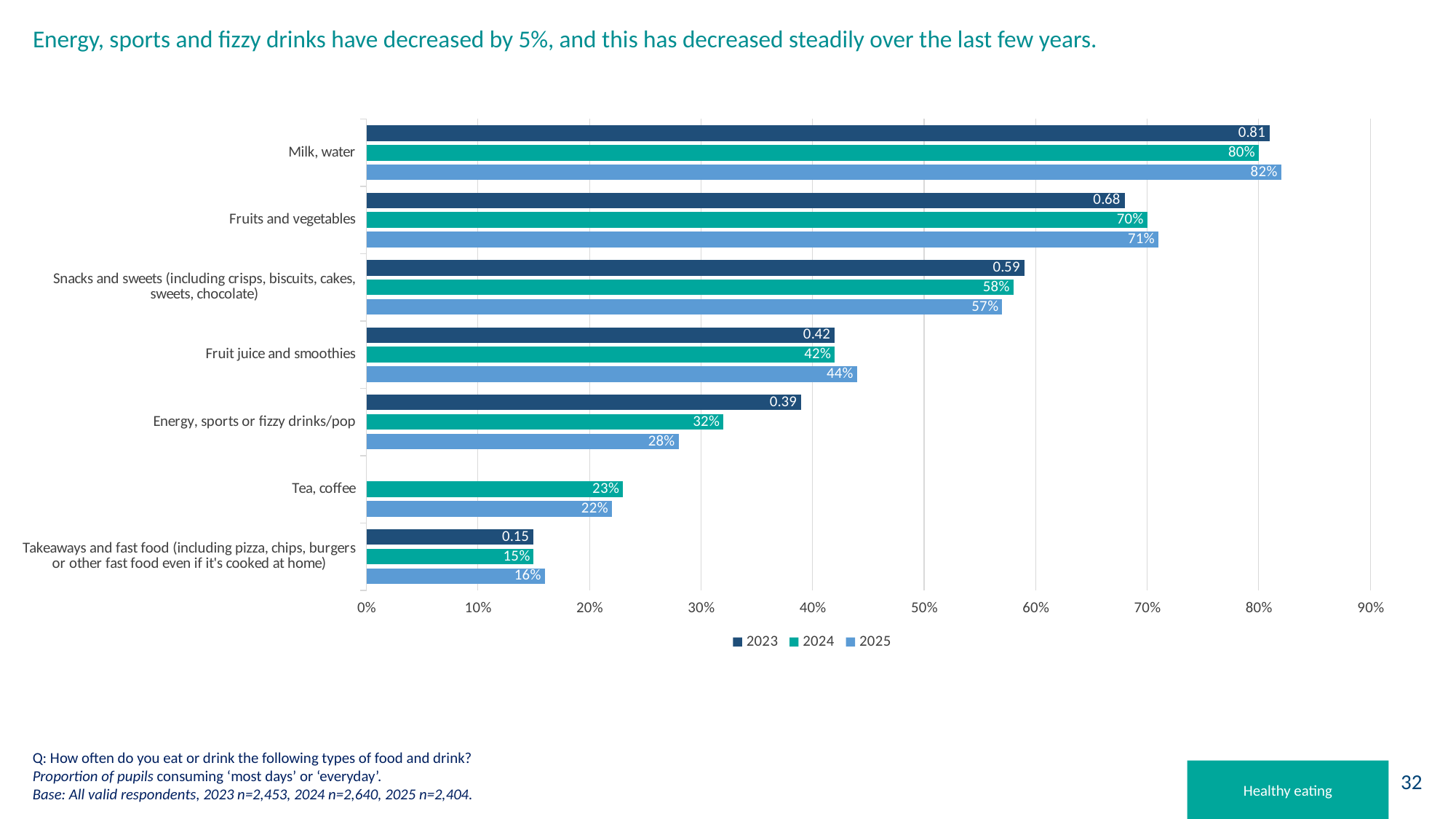
Which is larger for Fruit juice and smoothies: the 2024 value or the 2025 value? 2025 What is the difference between the 2024 and 2025 values for Energy, sports or fizzy drinks/pop? 4% What is the 2023 value shown for Fruits and vegetables? 0.68 What is the 2025 value for Tea, coffee? 22% How many series does the legend list? 3 What is the 2024 value for Energy, sports or fizzy drinks/pop? 32% What is the 2025 value for Milk, water? 82% How many food and drink categories are shown on the chart? 7 What kind of chart is shown on the slide? Bar chart Which category has the lowest 2024 value? Takeaways and fast food (including pizza, chips, burgers or other fast food even if it's cooked at home) Which category has the highest 2025 value? Milk, water Which category has no 2023 bar shown? Tea, coffee